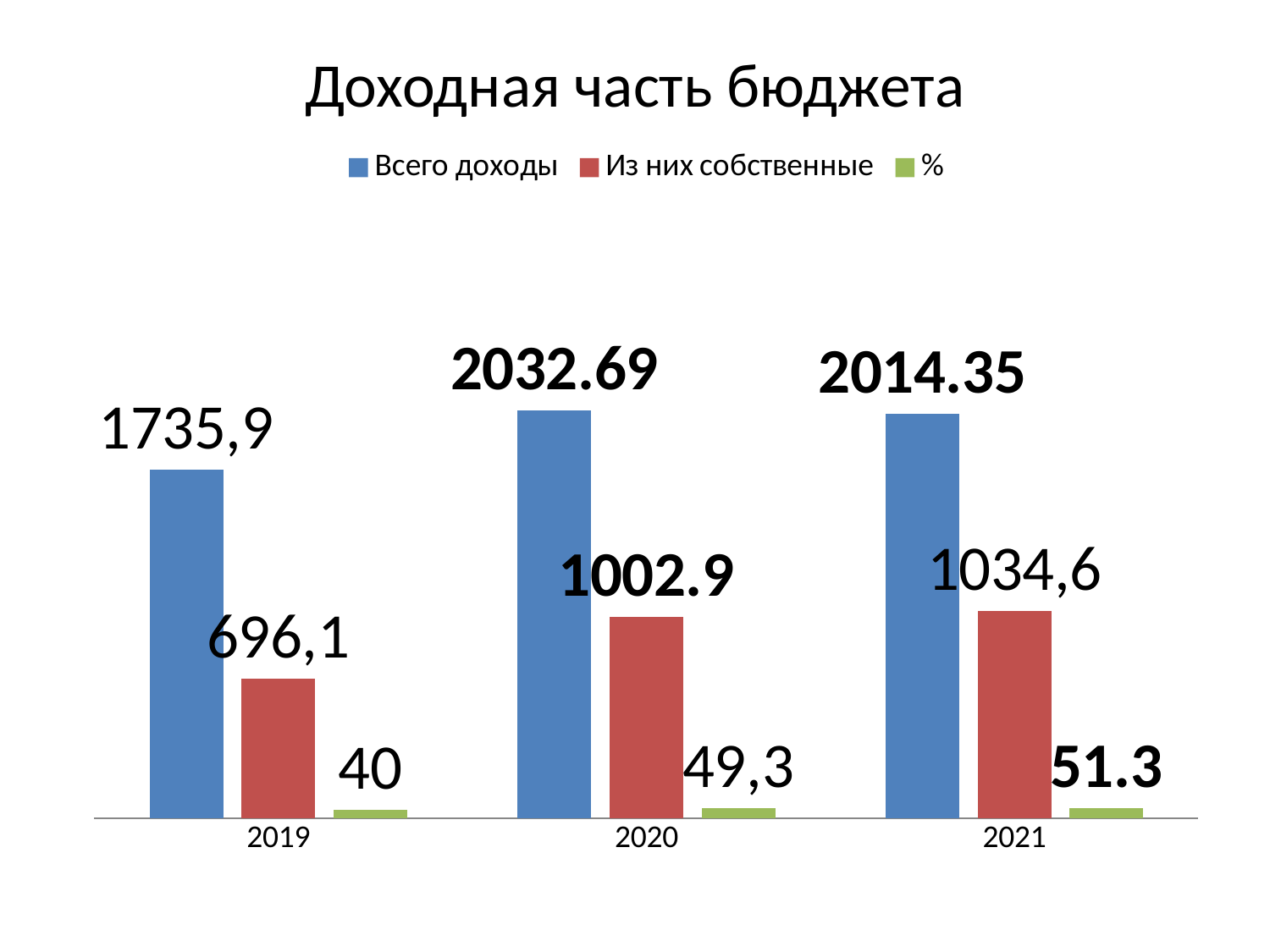
What is the difference between Из них собственные in 2021 and in 2019? 338,5 What kind of chart is shown on the slide? Bar chart How many years are shown on the x axis? 3 Which is larger: Всего доходы in 2020 or in 2021? 2020 How many series does the legend list? 3 What is the value of Из них собственные for 2021? 1034,6 What is the value of Всего доходы for 2019? 1735,9 In which year is Всего доходы the highest? 2020 What is the value of the % series for 2021? 51.3 What is the value of Из них собственные for 2020? 1002.9 What is the difference between the % value in 2021 and in 2019? 11.3 In which year is Из них собственные the lowest? 2019